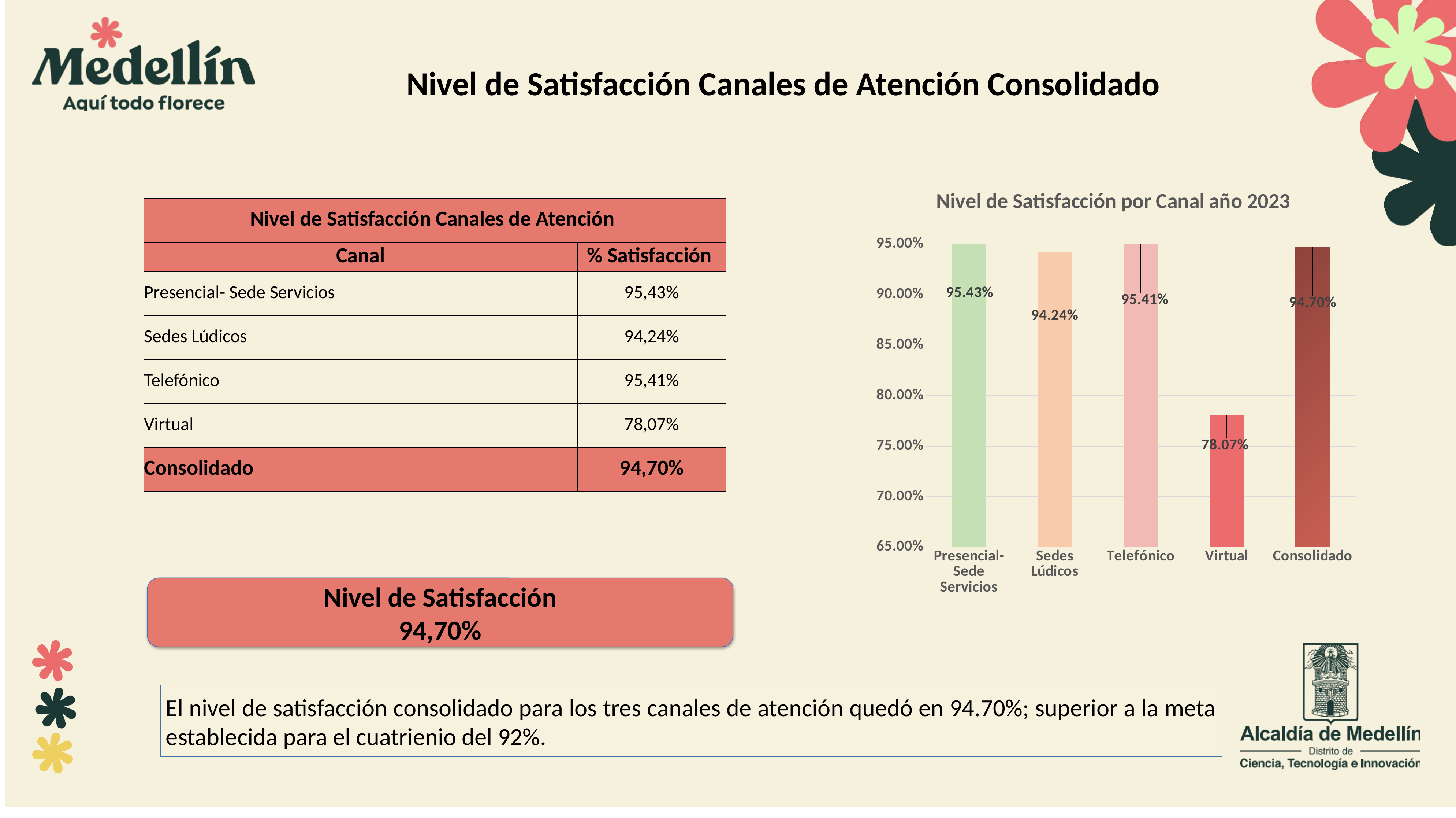
What is the value for Sedes Lúdicos in the chart? 94.24% What is the value for Consolidado in the chart? 94.70% What is the value for Presencial-Sede Servicios in the chart? 95.43% Which category has the lowest value in the chart? Virtual What kind of chart is shown on the slide? bar chart Which is larger, the value for Sedes Lúdicos or the value for Virtual? Sedes Lúdicos What is the difference between the values for Presencial-Sede Servicios and Virtual? 17.36% What is the title of the chart? Nivel de Satisfacción por Canal año 2023 Is the value for Virtual greater or less than 80.00%? less What is the value for Virtual in the chart? 78.07% What is the value for Telefónico in the chart? 95.41% How many categories are shown on the x axis of the chart? 5